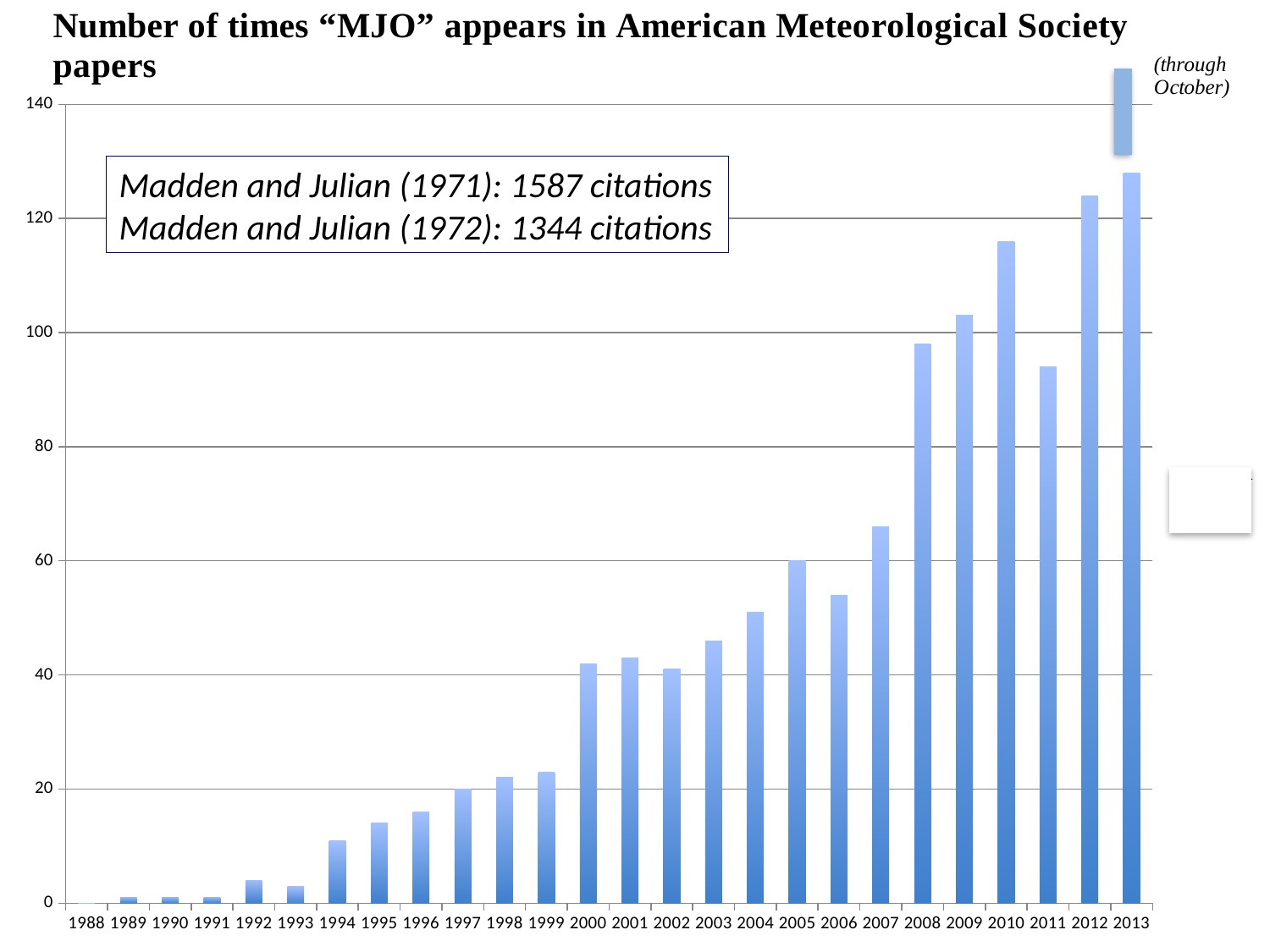
How many years are shown along the x axis of the chart? 26 Is the value for 1994 greater or less than 20? less What kind of chart is shown on the slide? bar chart Is the value for 2011 greater or less than 100? less Which year has the lowest number of times "MJO" appears in AMS papers? 1988 Which year has the larger value, 2011 or 2012? 2012 Is the value for 2013 greater or less than 120? greater Overall, do the values rise or fall from 1988 to 2013? rise Which year has the highest number of times "MJO" appears in AMS papers? 2013 According to the note next to the last bar, through which month does the 2013 count run? October